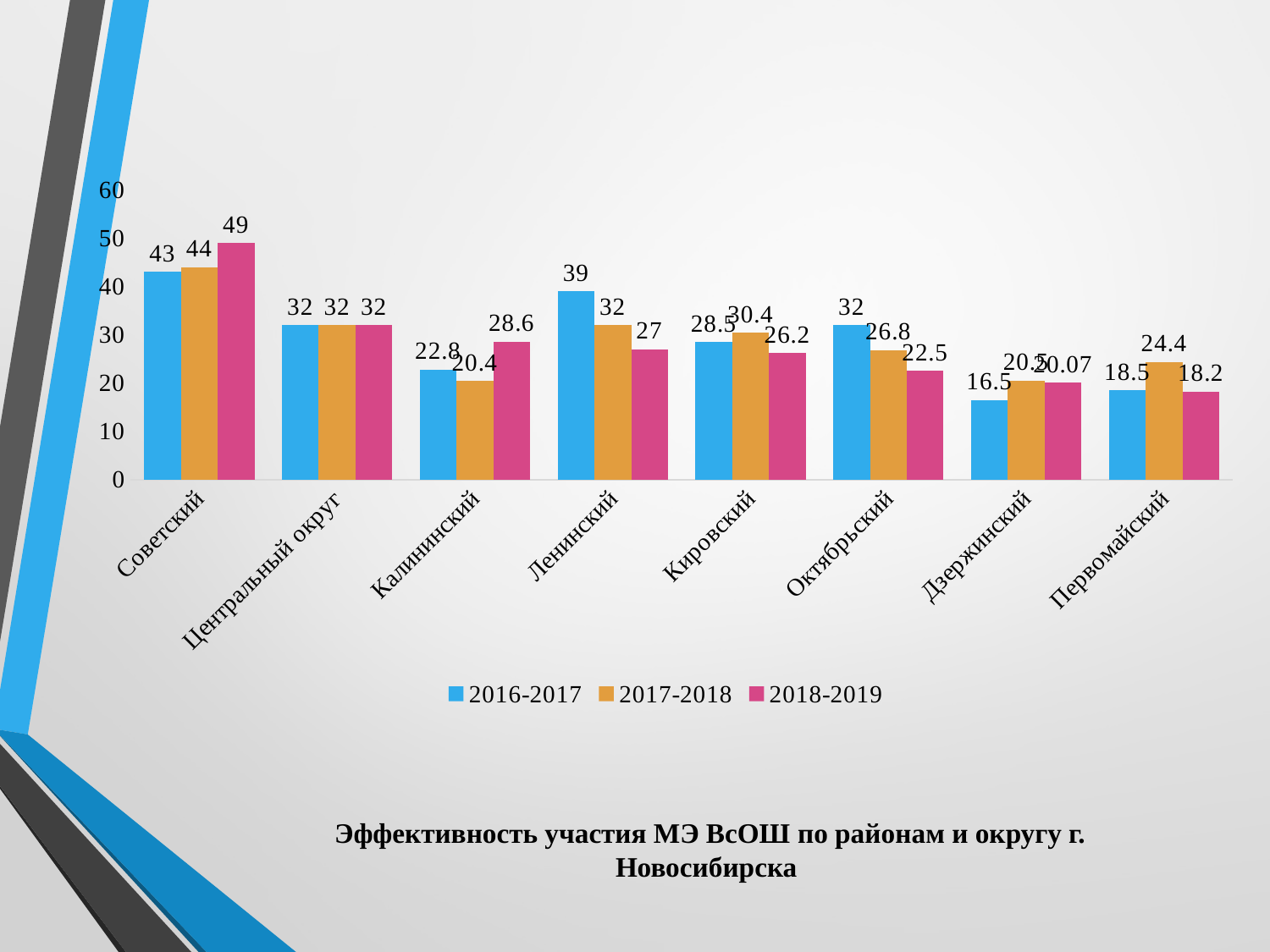
Which is larger for Октябрьский: the 2016-2017 value or the 2018-2019 value? 2016-2017 What is the value for Советский in the 2018-2019 series? 49 How many categories are shown on the x axis? 8 What is the value for Ленинский in the 2016-2017 series? 39 What is the difference between the 2016-2017 and 2018-2019 values for Ленинский? 12 What is the title of the chart? Эффективность участия МЭ ВсОШ по районам и округу г. Новосибирска Which category has the lowest value in the 2016-2017 series? Дзержинский Which category has the highest value in the 2018-2019 series? Советский How many series does the legend list? 3 What kind of chart is shown on the slide? bar chart What is the value for Первомайский in the 2017-2018 series? 24.4 What is the value for Калининский in the 2017-2018 series? 20.4